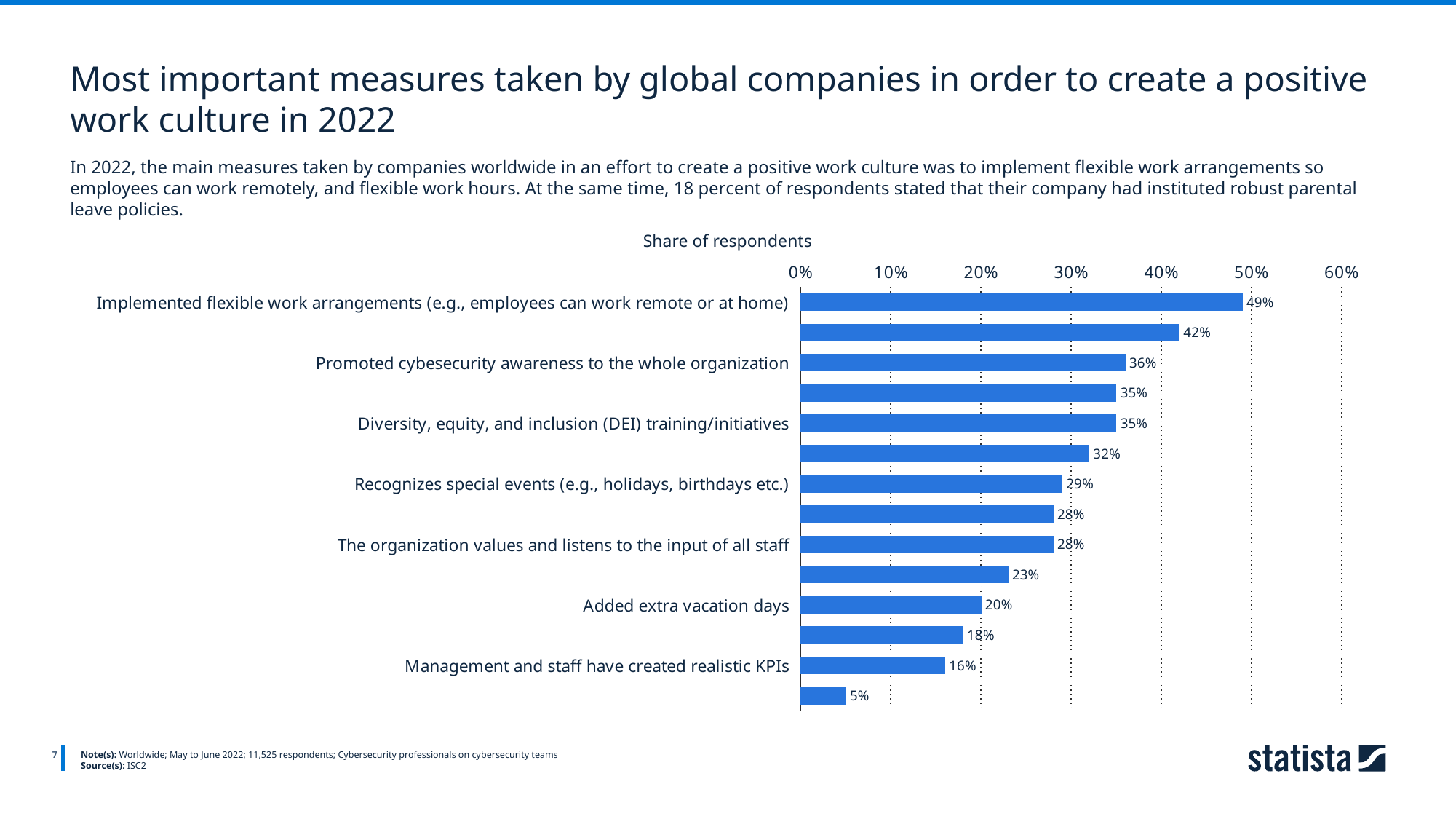
What type of chart is shown on the slide? Bar chart What is the difference between the share for 'Implemented flexible work arrangements' and the share for 'Promoted cybersecurity awareness to the whole organization'? 13% What is the value of the shortest bar in the chart? 5% Which is larger: the value for 'Recognizes special events (e.g., holidays, birthdays etc.)' or the value for 'The organization values and listens to the input of all staff'? Recognizes special events (e.g., holidays, birthdays etc.) What is the value for 'Management and staff have created realistic KPIs'? 16% What is the label of the value axis of the chart? Share of respondents What is the value for 'Promoted cybersecurity awareness to the whole organization'? 36% What share of respondents said their company implemented flexible work arrangements (e.g., employees can work remote or at home)? 49% How many bars are plotted in the chart? 14 What share of respondents reported diversity, equity, and inclusion (DEI) training/initiatives? 35% What is the value for 'Added extra vacation days'? 20% Which measure has the highest share of respondents? Implemented flexible work arrangements (e.g., employees can work remote or at home)